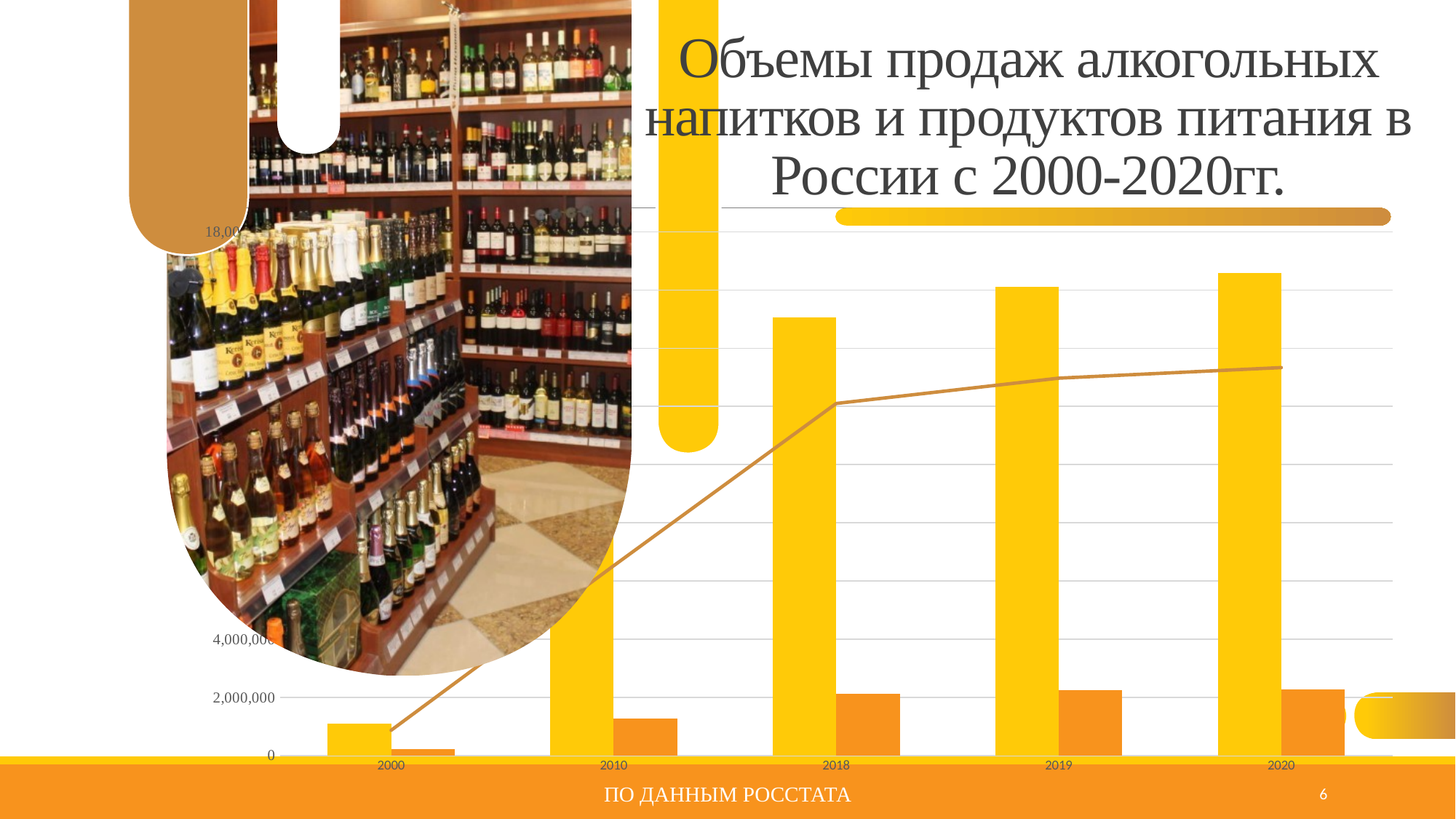
Do the yellow bars rise or fall from 2000 to 2020? rise Is the yellow bar for 2010 greater or less than 4,000,000? greater Is the orange bar for 2020 greater or less than 4,000,000? less Is the yellow bar for 2000 greater or less than 2,000,000? less Which year has the shortest yellow bar? 2000 In 2018, which is larger: the yellow bar or the orange bar? the yellow bar What kind of chart is shown on the slide? bar chart with a line What is the title of the chart on the slide? Объемы продаж алкогольных напитков и продуктов питания в России с 2000-2020гг. How many data series are plotted on the chart? 3 Which year has the shortest orange bar? 2000 How many years are shown along the x axis of the chart? 5 Which year has the tallest yellow bar? 2020